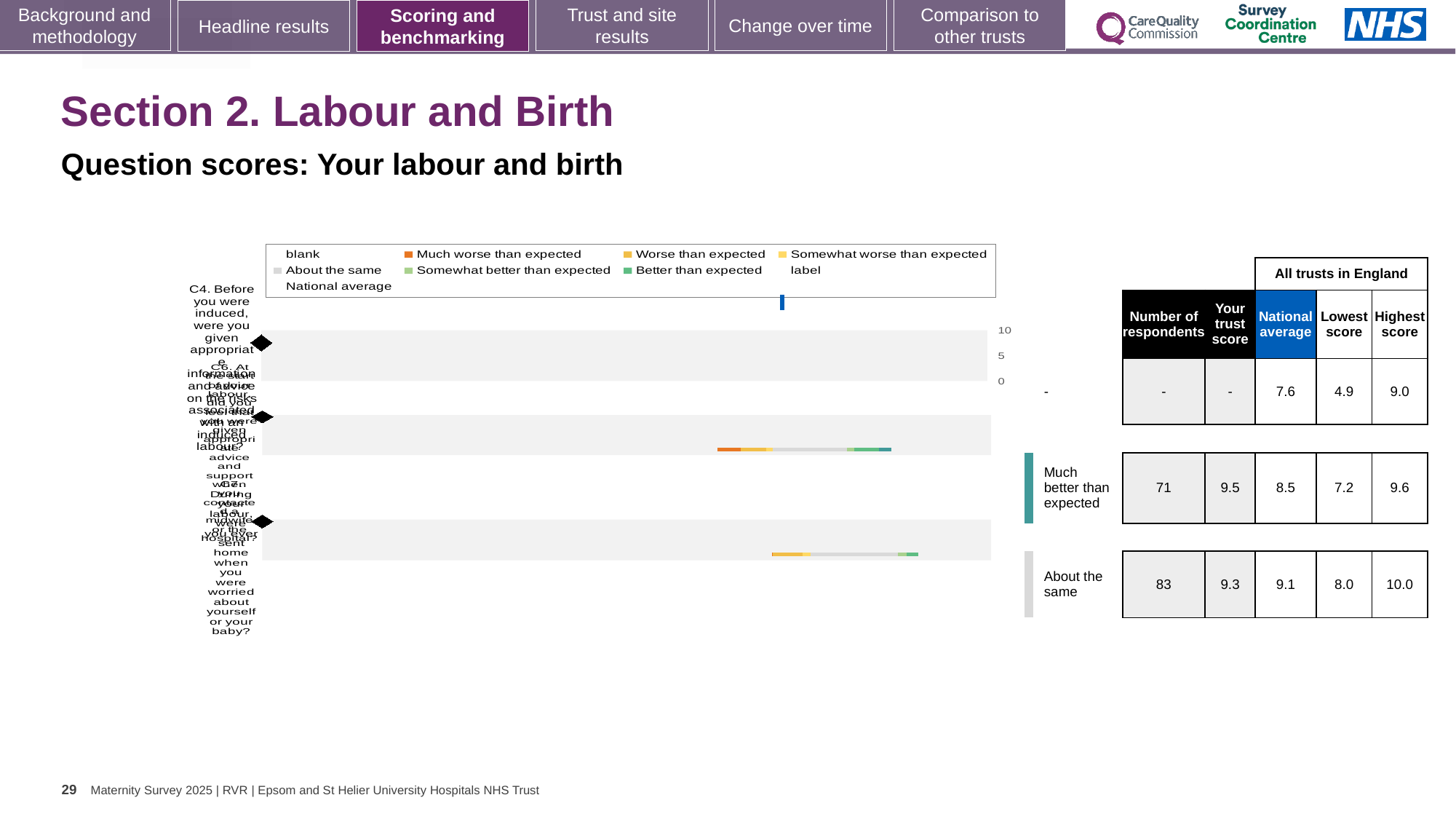
In the table beside the chart, what is the trust score for the row rated 'About the same'? 9.3 What is the highest tick value shown on the chart's value axis? 10 What kind of chart is shown on the slide? bar chart In the table beside the chart, what is the lowest score in England for the first row (C4)? 4.9 How many question rows (bars) does the chart show? 3 Which colour does the legend use for 'Much worse than expected'? orange In the table beside the chart, what is the national average for the first row (C4)? 7.6 In the table beside the chart, what is the difference between the trust score and the national average for the 'Much better than expected' row? 1.0 In the table beside the chart, which row has the higher trust score: 'Much better than expected' or 'About the same'? Much better than expected In the table beside the chart, what is the number of respondents for the row rated 'Much better than expected'? 71 In the table beside the chart, what is the highest score in England for the row rated 'About the same'? 10.0